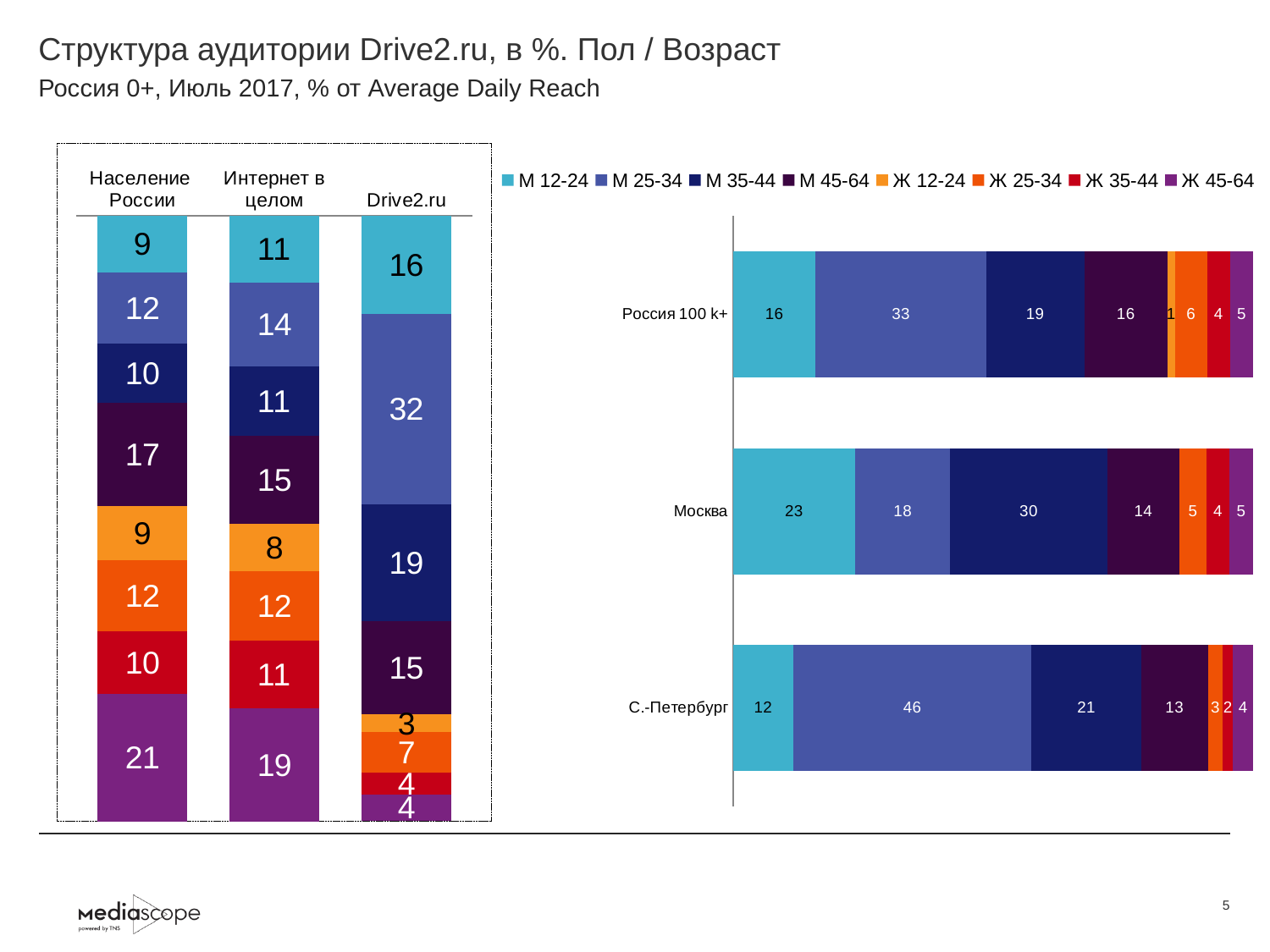
In the left chart, what is the value of the М 25-34 segment for Drive2.ru? 32 In the right chart, what is the value of the М 35-44 segment for Москва? 30 In the left chart, what is the value of the Ж 45-64 segment for Население России? 21 In the left chart, which segment is the largest in the Drive2.ru bar? М 25-34 In the right chart, what is the value of the М 25-34 segment for С.-Петербург? 46 In the right chart, which row has the largest М 12-24 segment? Москва In the left chart, what is the difference between the М 25-34 values for Drive2.ru and Население России? 20 In the right chart, what is the total of the М 12-24 and М 25-34 segments for Россия 100 k+? 49 What kind of chart is the left chart? Stacked bar chart In the right chart, which is larger: the М 45-64 value for Россия 100 k+ or for С.-Петербург? Россия 100 k+ How many bars does the right chart have? 3 How many series does the legend list? 8